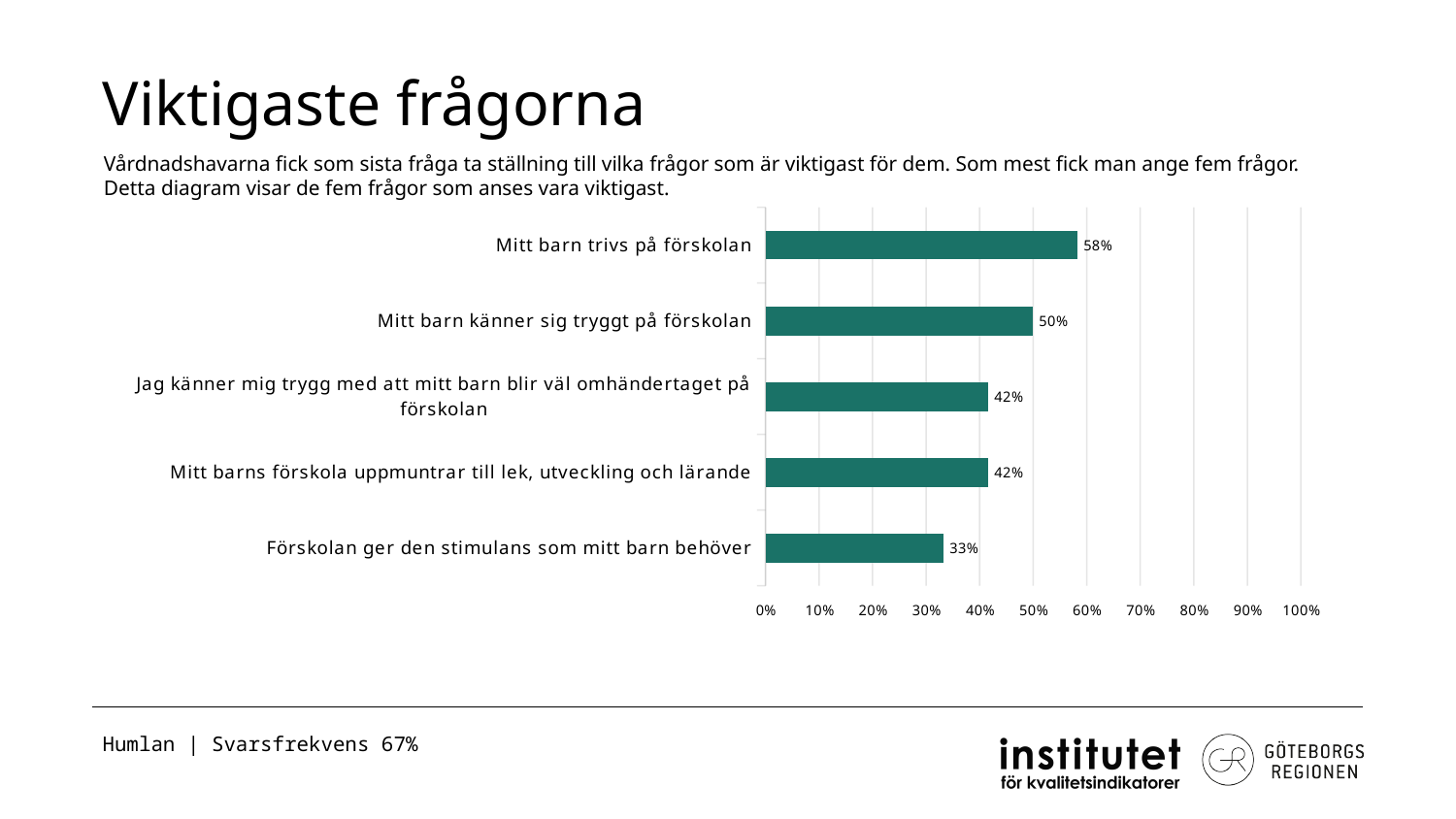
Which category has the highest value? Mitt barn trivs på förskolan What kind of chart is shown on the slide? bar chart What is the difference between the values for "Mitt barn känner sig tryggt på förskolan" and "Mitt barns förskola uppmuntrar till lek, utveckling och lärande"? 8% What is the difference between the values for "Mitt barn trivs på förskolan" and "Förskolan ger den stimulans som mitt barn behöver"? 25% How many categories are shown in the chart? 5 What is the value for "Förskolan ger den stimulans som mitt barn behöver"? 33% What is the value for "Mitt barn känner sig tryggt på förskolan"? 50% What is the value for "Mitt barns förskola uppmuntrar till lek, utveckling och lärande"? 42% What is the value for "Mitt barn trivs på förskolan"? 58% Is the value for "Förskolan ger den stimulans som mitt barn behöver" greater or less than 40%? less Which is larger: the value for "Mitt barn trivs på förskolan" or the value for "Mitt barn känner sig tryggt på förskolan"? Mitt barn trivs på förskolan Which category has the lowest value? Förskolan ger den stimulans som mitt barn behöver